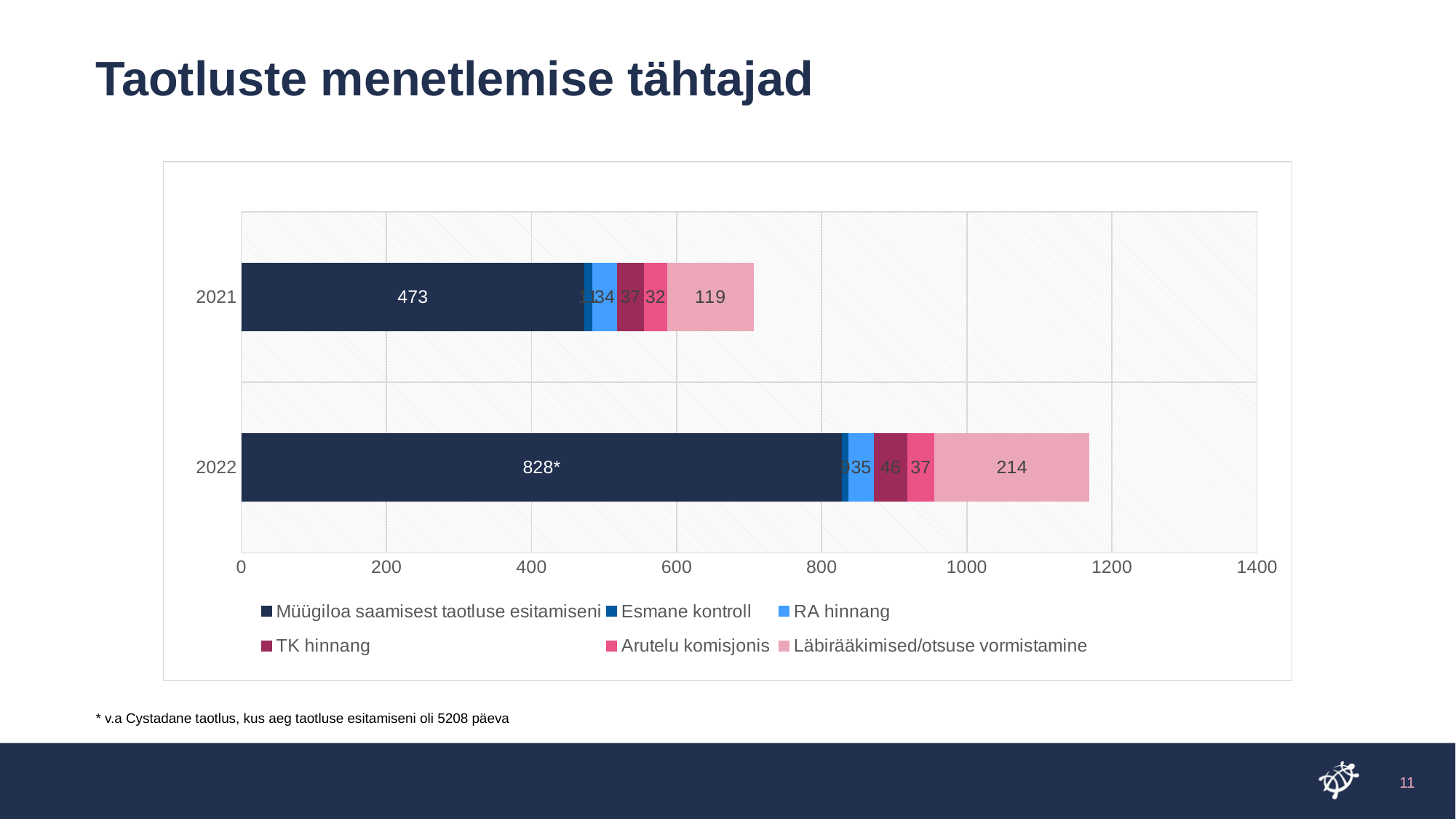
How many years (categories) are plotted on the chart? 2 What is the value of Läbirääkimised/otsuse vormistamine for 2022? 214 What is the difference between the Läbirääkimised/otsuse vormistamine values for 2022 and 2021? 95 Is the total length of the 2022 bar greater or less than 1000? greater Is the total length of the 2021 bar greater or less than 800? less What is the value of Müügiloa saamisest taotluse esitamiseni for 2021? 473 What is the value of TK hinnang for 2022? 46 What is the title of the chart on the slide? Taotluste menetlemise tähtajad What kind of chart is shown on the slide? Stacked bar chart How many series does the legend list? 6 What is the value of Arutelu komisjonis for 2021? 32 Which year has the larger value for Müügiloa saamisest taotluse esitamiseni, 2021 or 2022? 2022